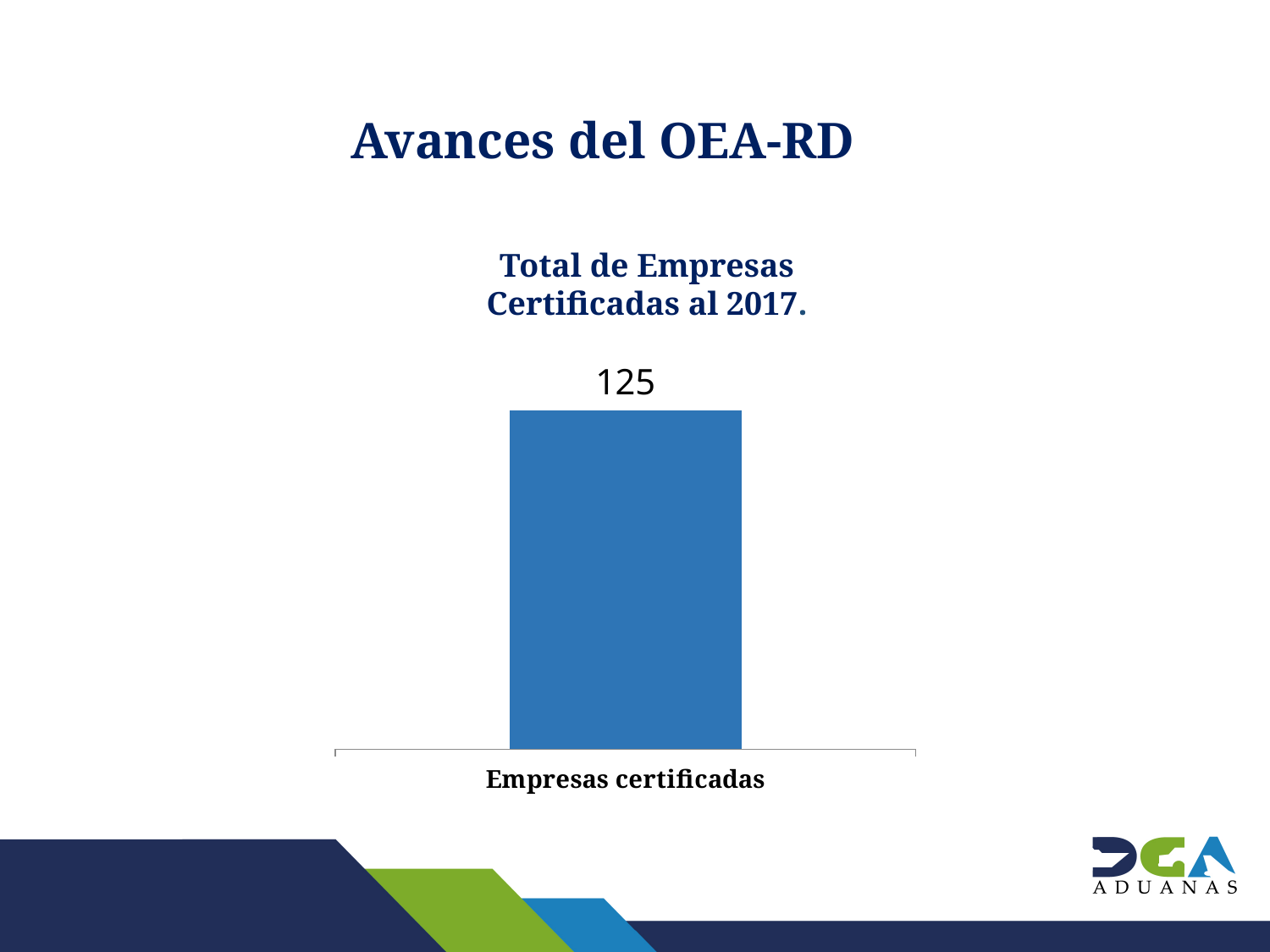
How many bars does the chart show? 1 What kind of chart is shown on the slide? bar chart What is the label of the category on the x axis? Empresas certificadas What is the title of the chart? Total de Empresas Certificadas al 2017. Is the value for Empresas certificadas greater or less than 100? greater What is the value for Empresas certificadas? 125